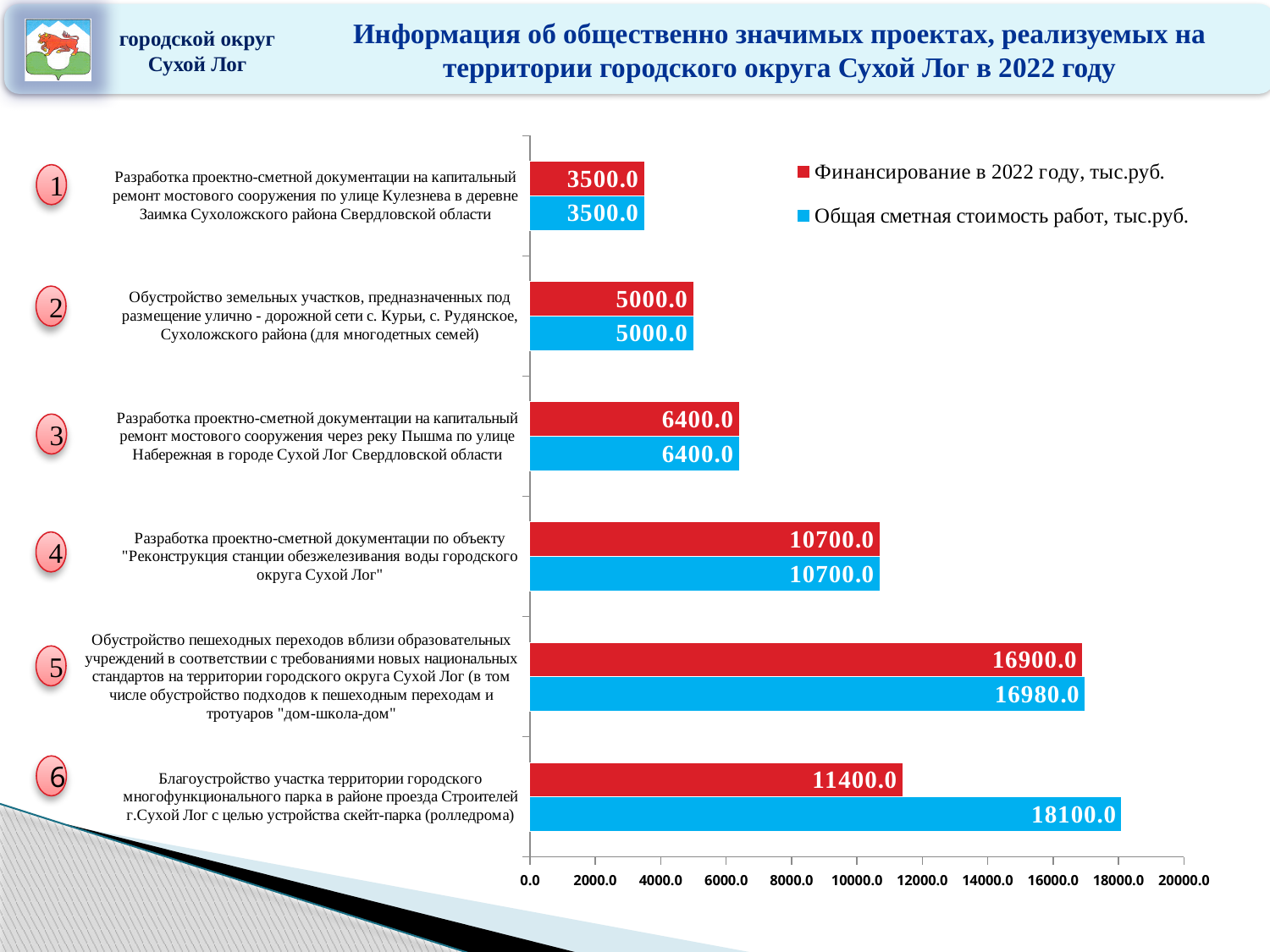
Which colour represents the series "Финансирование в 2022 году, тыс.руб." in the chart? red What is the value of "Финансирование в 2022 году, тыс.руб." for project 6 (Благоустройство участка территории городского многофункционального парка ... скейт-парка)? 11400.0 What is the value of "Общая сметная стоимость работ, тыс.руб." for project 5 (Обустройство пешеходных переходов вблизи образовательных учреждений)? 16980.0 Which project has the lowest "Общая сметная стоимость работ, тыс.руб."? Project 1 (Разработка проектно-сметной документации на капитальный ремонт мостового сооружения по улице Кулезнева в деревне Заимка) Which project has the highest "Финансирование в 2022 году, тыс.руб."? Project 5 (Обустройство пешеходных переходов вблизи образовательных учреждений) What is the difference between "Общая сметная стоимость работ" and "Финансирование в 2022 году" for project 6 (скейт-парк)? 6700.0 What is the value of "Финансирование в 2022 году, тыс.руб." for project 4 (Реконструкция станции обезжелезивания воды)? 10700.0 What is the difference between "Общая сметная стоимость работ" and "Финансирование в 2022 году" for project 5 (Обустройство пешеходных переходов)? 80.0 What type of chart is shown on the slide? bar chart How many series does the chart legend list? 2 How many projects (categories) are plotted in the chart? 6 What is the value of "Общая сметная стоимость работ, тыс.руб." for project 6 (Благоустройство участка территории городского многофункционального парка ... скейт-парка)? 18100.0